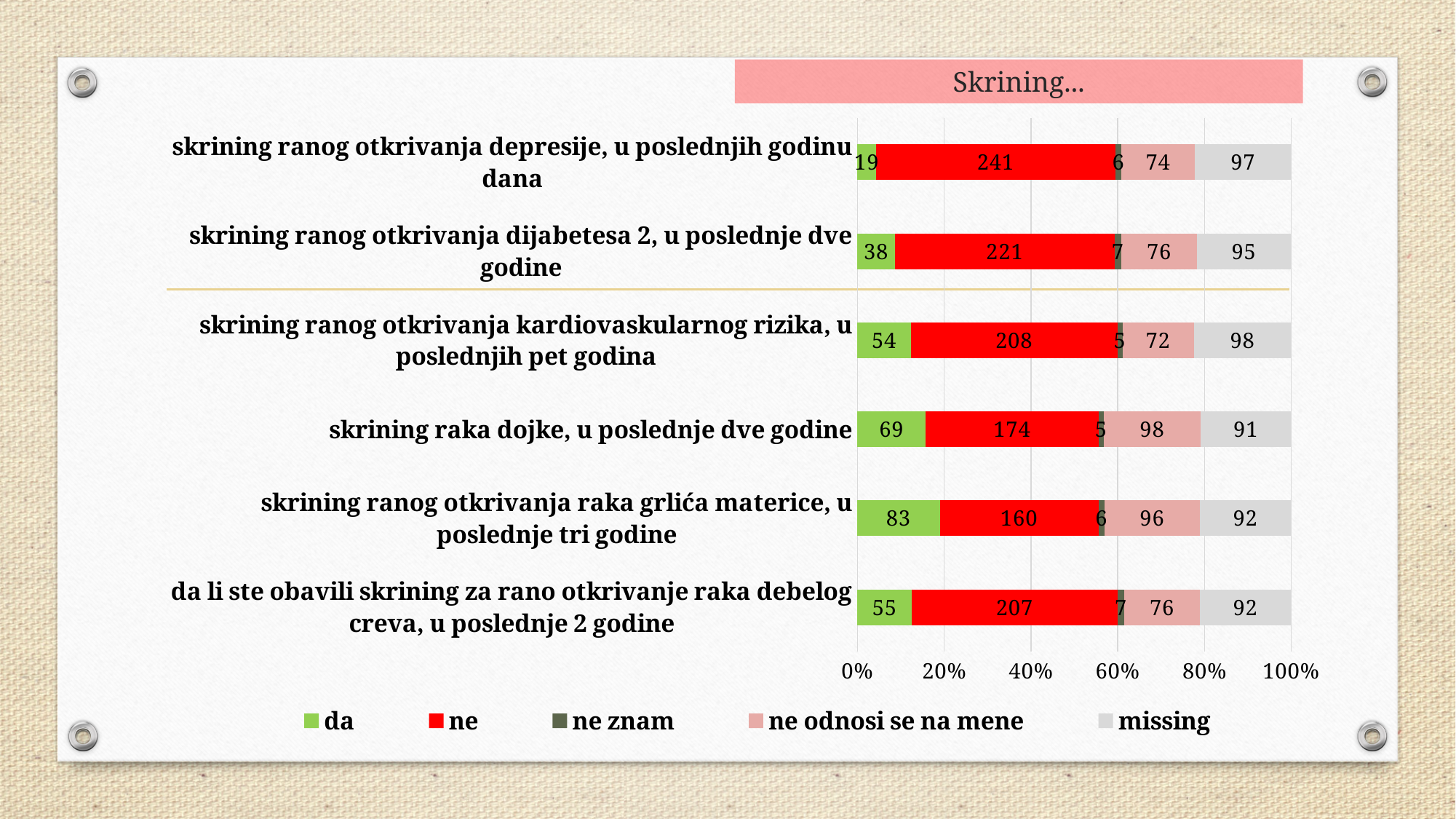
What is the difference between the "ne" values for "skrining ranog otkrivanja depresije" and "skrining ranog otkrivanja raka grlića materice"? 81 What is the "missing" value for "skrining ranog otkrivanja kardiovaskularnog rizika, u poslednjih pet godina"? 98 Which legend entry is shown in red? ne What is the total of all segments in the "skrining raka dojke, u poslednje dve godine" bar? 437 What is the value for "da" in the "skrining raka dojke, u poslednje dve godine" bar? 69 How many categories (bars) are shown in the chart? 6 Which category has the lowest "da" value? skrining ranog otkrivanja depresije, u poslednjih godinu dana How many series does the legend list? 5 Which is larger: the "ne odnosi se na mene" value for "skrining raka dojke" or for "skrining ranog otkrivanja dijabetesa 2"? skrining raka dojke What kind of chart is shown on the slide? stacked bar chart What is the value for "ne" in the "skrining ranog otkrivanja depresije, u poslednjih godinu dana" bar? 241 Which category has the highest "da" value? skrining ranog otkrivanja raka grlića materice, u poslednje tri godine